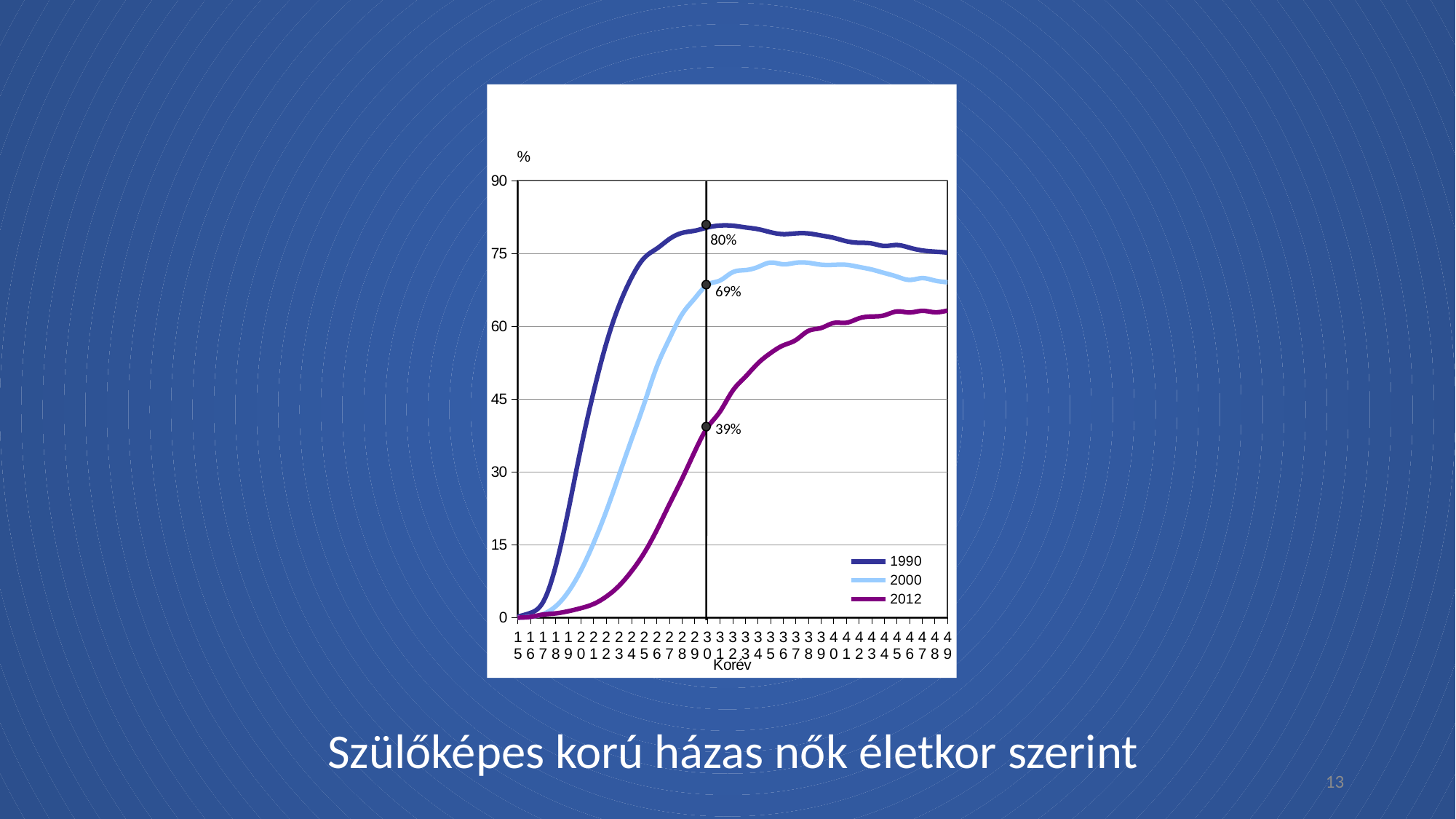
How many series does the legend list? 3 What is the value for the 2012 series at age 30? 39% What is the value for the 1990 series at age 30? 80% What is the value for the 2000 series at age 30? 69% What kind of chart is shown on the slide? line chart What is the difference between the 1990 and 2012 values at age 30? 41% Which series has the lowest value at age 30? 2012 Does the 2012 series rise or fall between age 15 and age 30? rise Which years are listed in the chart's legend? 1990, 2000, 2012 Which series has the highest value at age 30? 1990 Is the value for the 2012 series at age 45 greater or less than 45? greater What is the difference between the 1990 and 2000 values at age 30? 11%